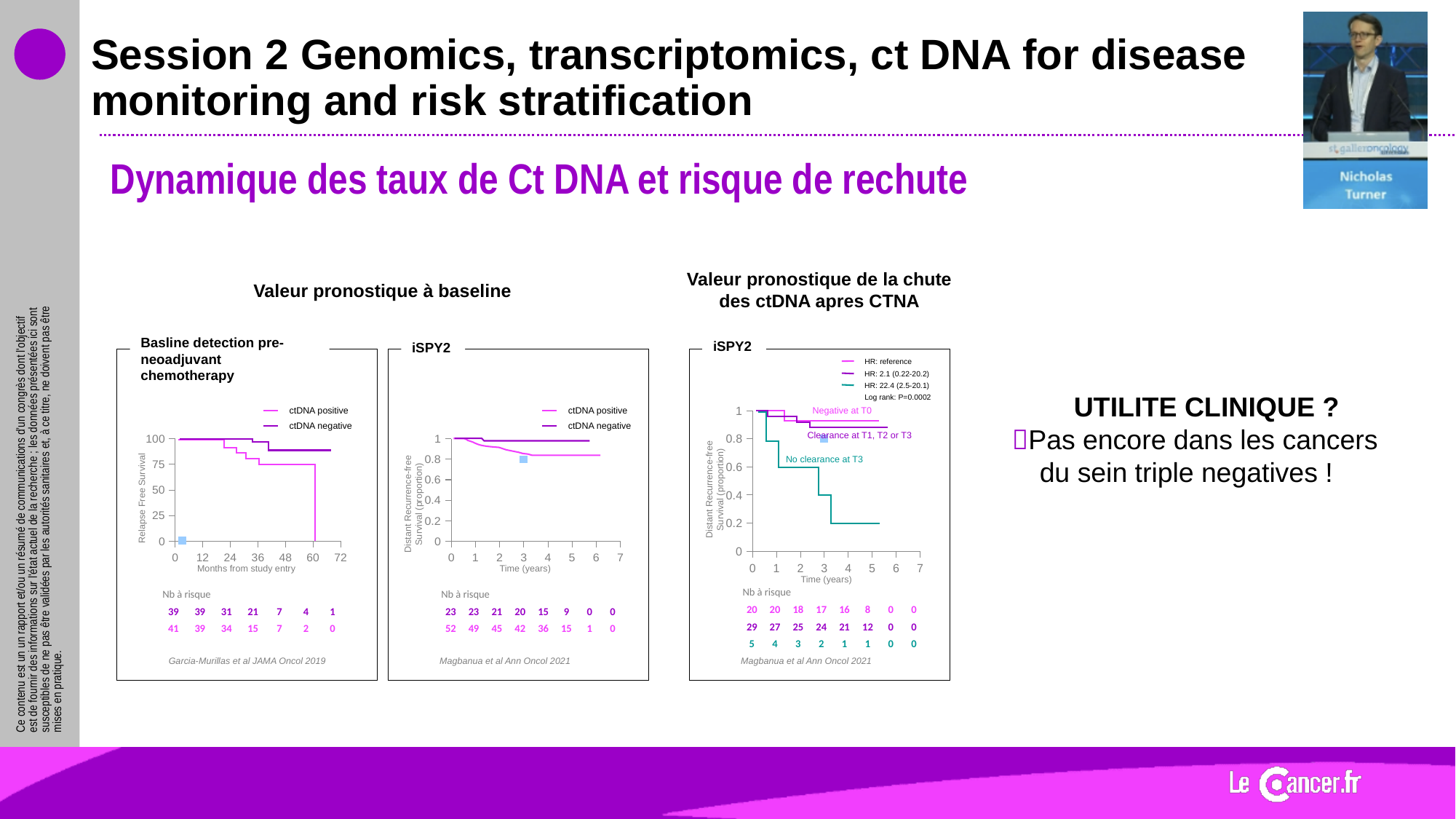
In the left chart (Basline detection pre-neoadjuvant chemotherapy), is the ctDNA negative curve at 48 months greater or less than 75? greater In the right chart (iSPY2, Valeur pronostique de la chute des ctDNA apres CTNA), is the 'No clearance at T3' curve at 5 years greater or less than 0.4? less In the middle chart (iSPY2, Valeur pronostique à baseline), what is the first value in the second row of the 'Nb à risque' table? 52 In the left chart (Basline detection pre-neoadjuvant chemotherapy), what are the two legend entries? ctDNA positive, ctDNA negative In the middle chart (iSPY2, Valeur pronostique à baseline), is the ctDNA negative curve at 5 years greater or less than 0.8? greater What kind of chart is the left chart titled 'Basline detection pre-neoadjuvant chemotherapy'? Kaplan-Meier survival curve (line chart) In the left chart (Basline detection pre-neoadjuvant chemotherapy), what is the first value in the second row of the 'Nb à risque' table? 41 In the right chart (iSPY2, Valeur pronostique de la chute des ctDNA apres CTNA), how many curves are plotted? 3 In the left chart (Basline detection pre-neoadjuvant chemotherapy), what is the first value in the first row of the 'Nb à risque' table? 39 How many series does the legend of the left chart (Basline detection pre-neoadjuvant chemotherapy) list? 2 In the right chart (iSPY2, Valeur pronostique de la chute des ctDNA apres CTNA), what log rank P value is shown? P=0.0002 In the left chart (Basline detection pre-neoadjuvant chemotherapy), what is the x-axis label? Months from study entry